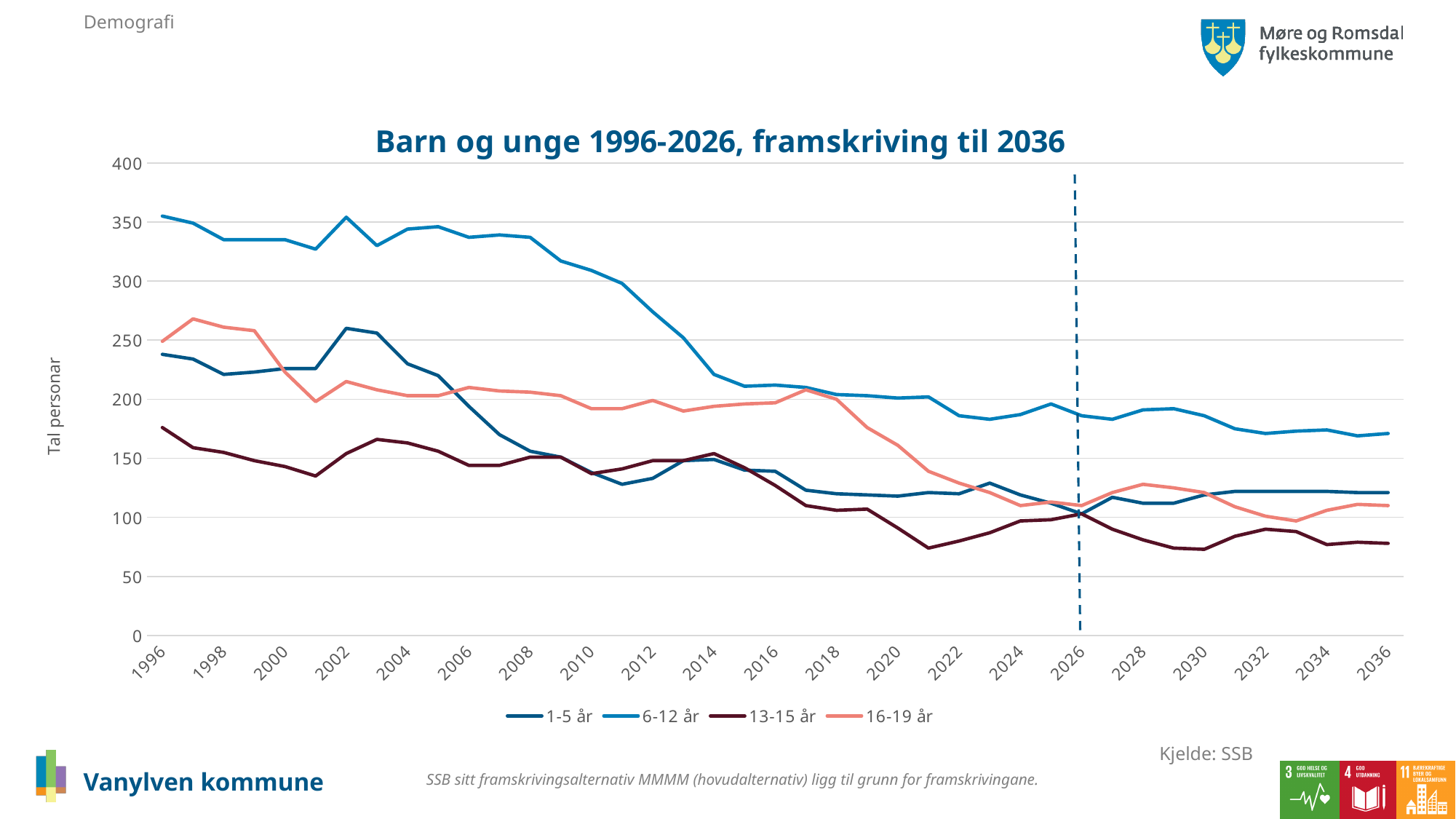
Does the 6-12 år series generally rise or fall from 1996 to 2036? fall Which series has the highest value in 1996? 6-12 år How many series does the legend list? 4 Which series has the lowest value in 2036? 13-15 år In 1998, which is larger: the value for 16-19 år or the value for 1-5 år? 16-19 år What kind of chart is shown on the slide? line chart Is the value for 6-12 år in 1996 greater or less than 300? greater Which series has the lowest value in 1996? 13-15 år What is the title of the chart? Barn og unge 1996-2026, framskriving til 2036 Is the value for 6-12 år in 2036 greater or less than 150? greater Is the value for 13-15 år in 2036 greater or less than 100? less What is the label on the vertical axis? Tal personar